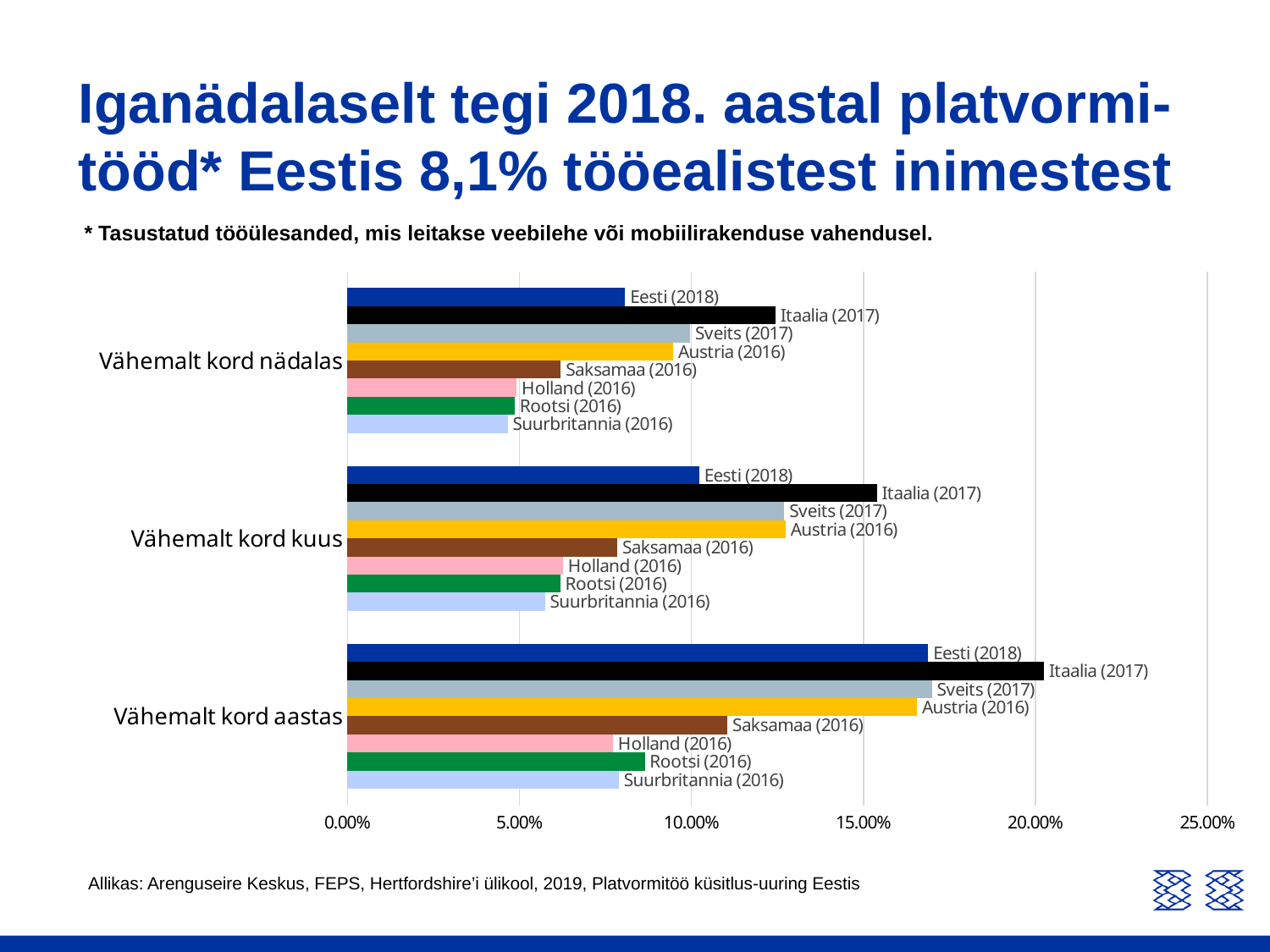
In the 'Vähemalt kord kuus' group, which is larger: Eesti (2018) or Austria (2016)? Austria (2016) Is the value for Eesti (2018) in the 'Vähemalt kord nädalas' group greater or less than 10.00%? less In the 'Vähemalt kord aastas' group, which is larger: Saksamaa (2016) or Holland (2016)? Saksamaa (2016) Is the value for Eesti (2018) in the 'Vähemalt kord aastas' group greater or less than 15.00%? greater Which country has the highest value in the 'Vähemalt kord aastas' group? Itaalia (2017) What is the highest value shown on the horizontal axis of the chart? 25.00% How many countries are plotted within each frequency category? 8 Is the value for Itaalia (2017) in the 'Vähemalt kord nädalas' group greater or less than 10.00%? greater Which country has the highest value in the 'Vähemalt kord nädalas' group? Itaalia (2017) What kind of chart is shown on the slide? bar chart How many frequency categories (groups of bars) does the chart show? 3